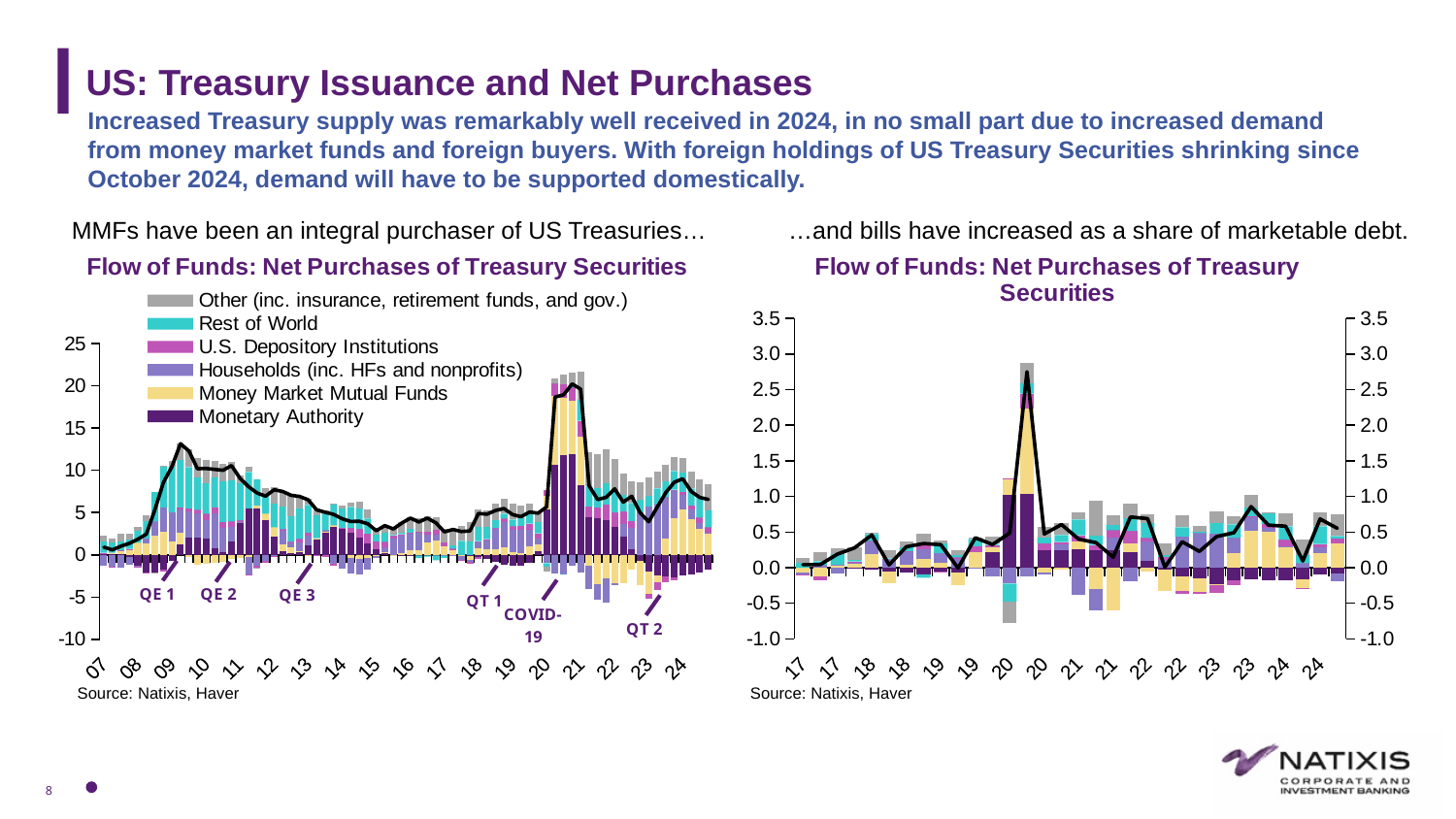
What kind of chart is the right chart on the slide? combination bar and line chart In the right chart, is the value of the black line in 2023 greater or less than 1.5? less In the left chart, which legend entry is listed first? Other (inc. insurance, retirement funds, and gov.) In the left chart, what is the first year label on the x axis? 07 In the left chart, is the peak value of the black line around 2020 greater or less than 15? greater In the left chart, is the value of the black line in 2009 greater or less than 10? greater What kind of chart is the left chart, 'Flow of Funds: Net Purchases of Treasury Securities'? combination bar and line chart How many series does the legend of the left chart list? 6 In the right chart, what is the highest tick shown on the y axis? 3.5